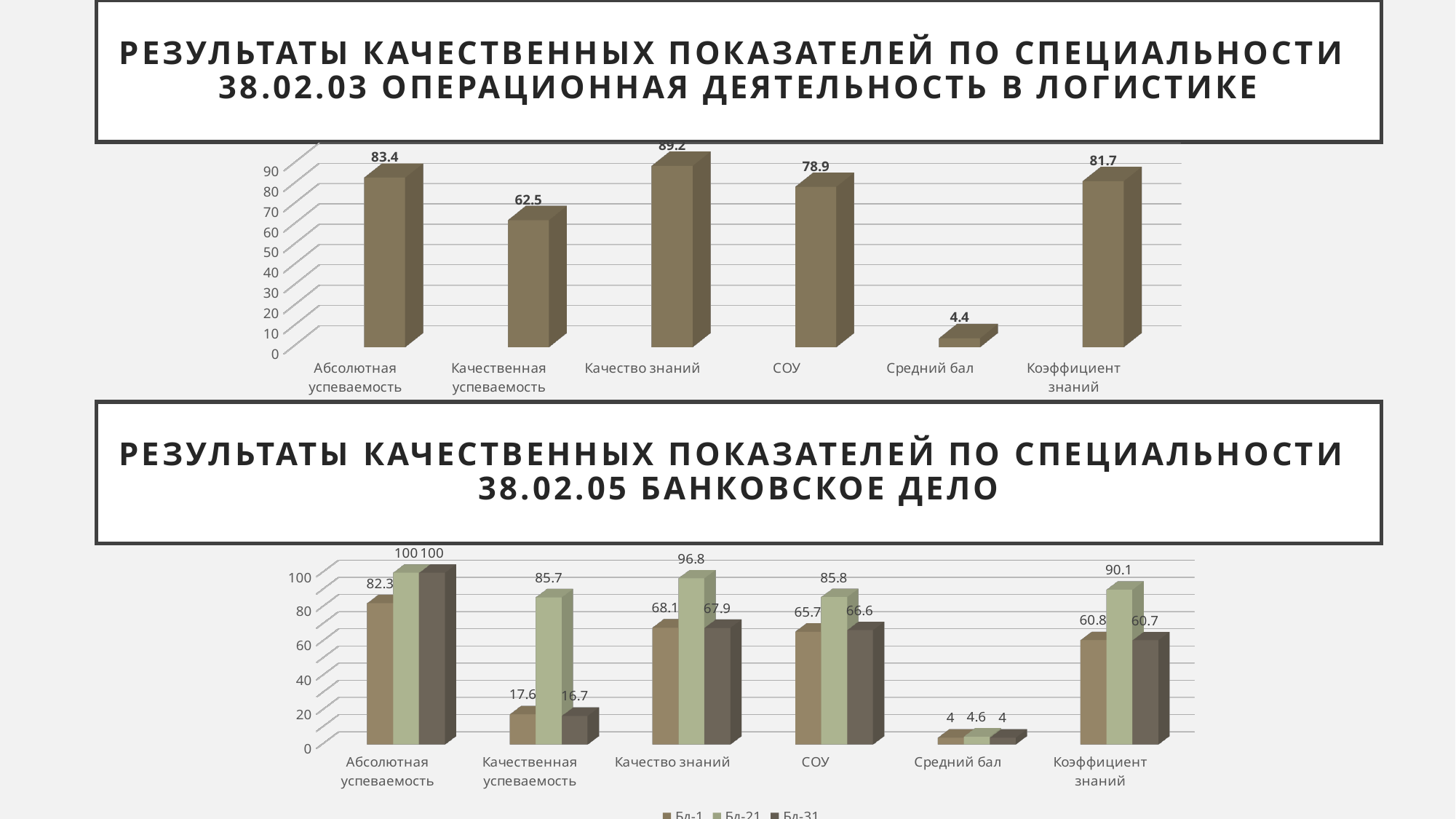
In the top chart (38.02.03 Операционная деятельность в логистике), what is the value for Абсолютная успеваемость? 83.4 In the bottom chart (38.02.05 Банковское дело), what is the difference between the middle (light green) series and the third (right) series for Коэффициент знаний? 29.4 In the top chart (38.02.03 Операционная деятельность в логистике), which category has the lowest value? Средний бал What kind of chart is the bottom chart (38.02.05 Банковское дело)? bar chart In the top chart (38.02.03 Операционная деятельность в логистике), what is the value for Средний бал? 4.4 In the bottom chart (38.02.05 Банковское дело), what is the value of the middle (light green) series for Качество знаний? 96.8 In the top chart (38.02.03 Операционная деятельность в логистике), which category has the highest value? Качество знаний In the bottom chart (38.02.05 Банковское дело), which is larger for СОУ: the first (left) series or the middle (light green) series? the middle (light green) series In the bottom chart (38.02.05 Банковское дело), what is the value of the first (left) series for Качественная успеваемость? 17.6 In the top chart (38.02.03 Операционная деятельность в логистике), what is the difference between Абсолютная успеваемость and Качественная успеваемость? 20.9 In the top chart (38.02.03 Операционная деятельность в логистике), how many categories are shown? 6 In the bottom chart (38.02.05 Банковское дело), how many series does the legend list? 3